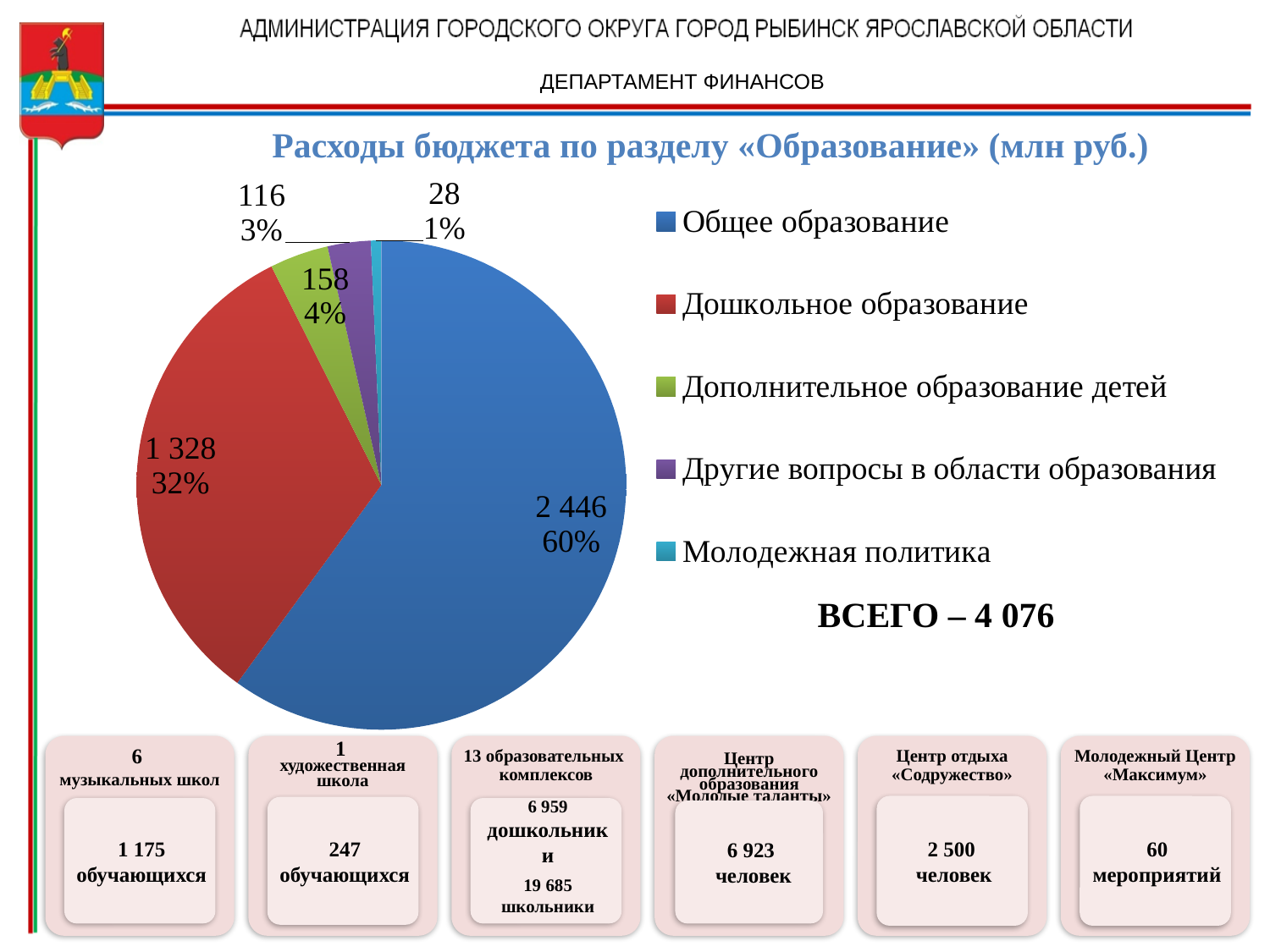
What is the value for Дошкольное образование? 1 328 What share of the pie does Дошкольное образование represent? 32% What is the value for Дополнительное образование детей? 158 Which category has the smallest slice of the pie? Молодежная политика What is the difference between the values for Общее образование and Дошкольное образование? 1 118 What kind of chart is shown on the slide? pie chart What share of the pie does Другие вопросы в области образования represent? 3% What is the value for Общее образование? 2 446 Which is larger, the value for Дополнительное образование детей or the value for Другие вопросы в области образования? Дополнительное образование детей Which category has the largest slice of the pie? Общее образование How many categories does the legend list? 5 What is the value for Молодежная политика? 28